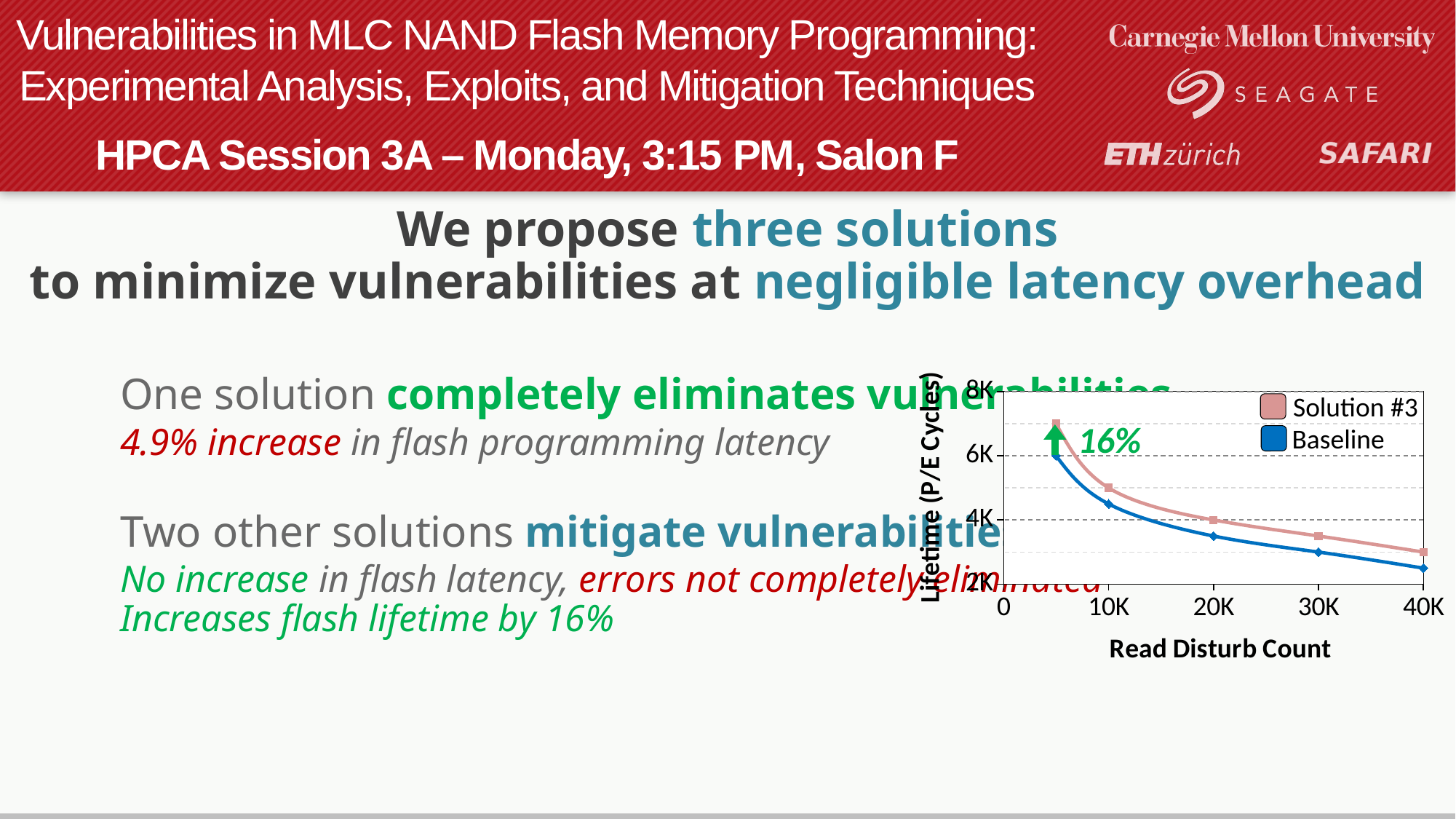
Is the Baseline lifetime at its first plotted point (near 5K read disturbs) greater or less than 4K? greater What is the title of the chart's x axis? Read Disturb Count Is the Baseline lifetime at a read disturb count of 40K greater or less than 4K? less Does the Solution #3 lifetime rise or fall as the read disturb count increases? fall How many series does the chart legend list? 2 Does the Baseline lifetime rise or fall as the read disturb count increases? fall Is the Solution #3 lifetime at a read disturb count of 40K greater or less than 4K? less What are the two series named in the chart legend? Solution #3 and Baseline What percentage improvement is annotated on the chart between Solution #3 and Baseline? 16% What kind of chart is shown on the slide? line chart At a read disturb count of 10K, which series has the higher lifetime, Solution #3 or Baseline? Solution #3